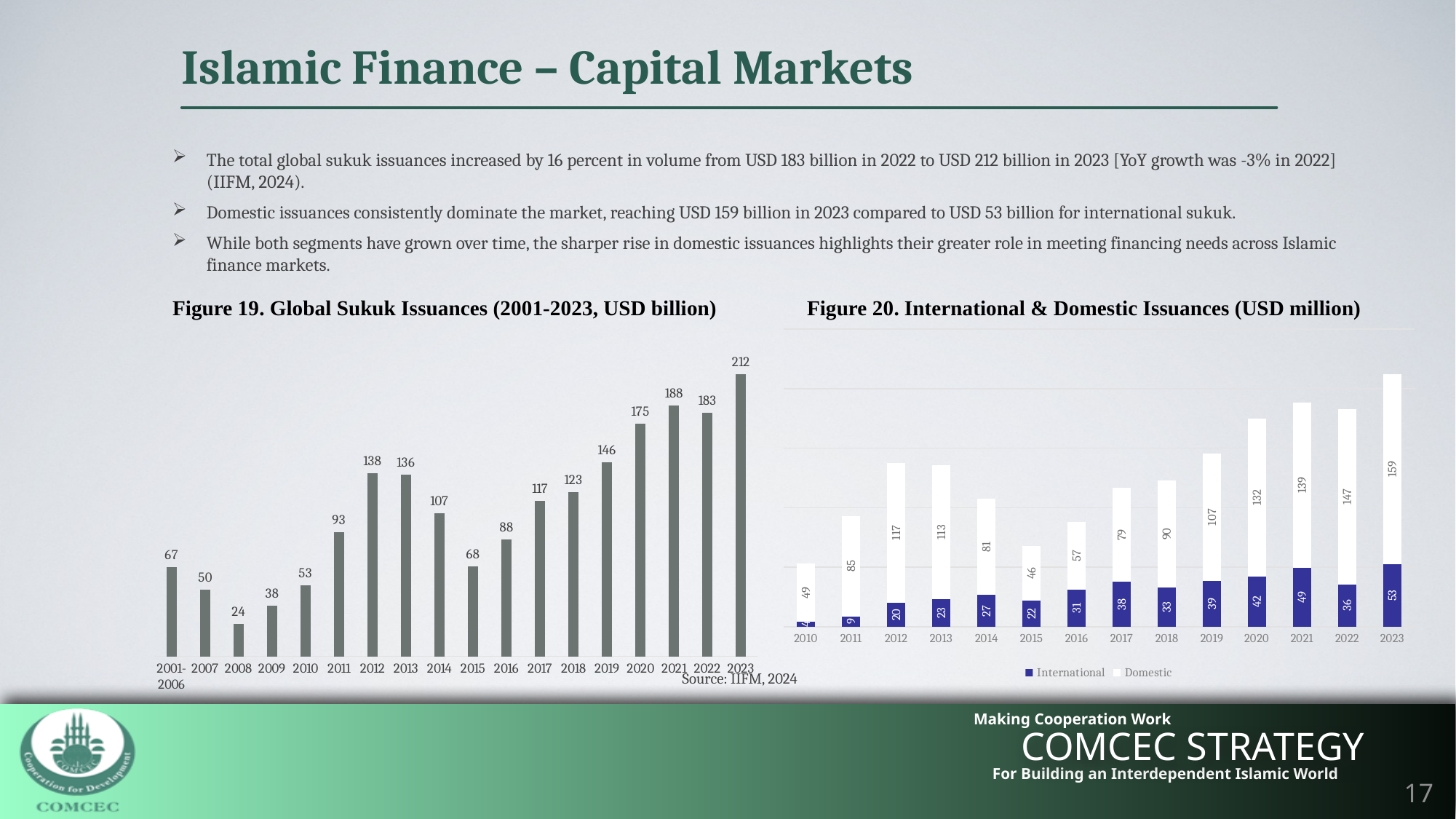
In Figure 19, what is the value of global sukuk issuances for 2023? 212 How many bars are shown in Figure 19? 18 In Figure 19, what is the difference between the values for 2023 and 2022? 29 In Figure 20, what is the Domestic value for 2023? 159 In Figure 20, what is the total of the stacked bar for 2023? 212 In Figure 20, which year has the larger International value, 2021 or 2022? 2021 In Figure 20, what is the International value for 2010? 4 In Figure 19, which year has the highest global sukuk issuances? 2023 In Figure 19, which category has the lowest value? 2008 What type of chart is Figure 19? Bar chart How many series does the legend of Figure 20 list? 2 In Figure 20, which year has the lowest Domestic value? 2015